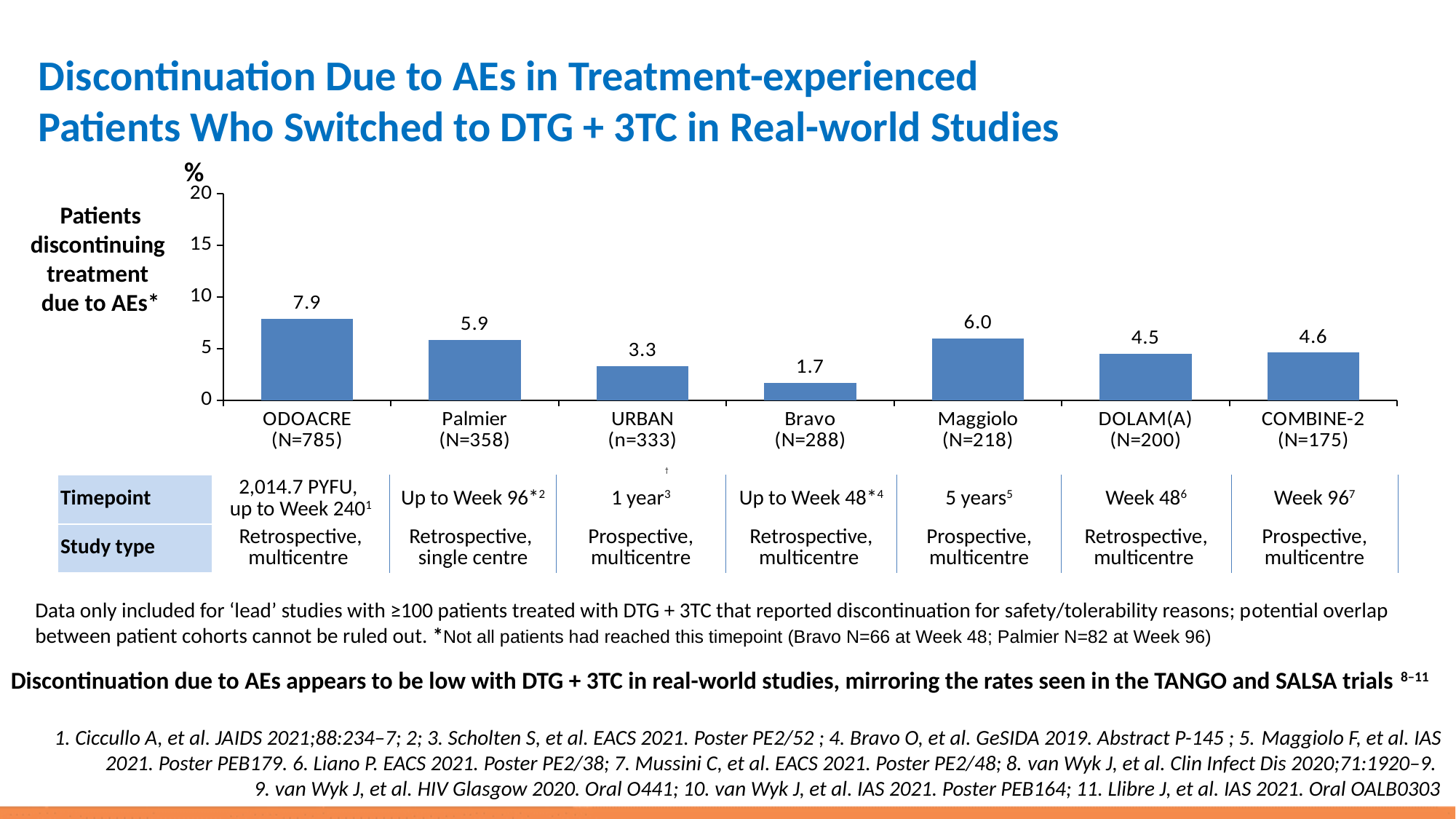
What is the value shown for the Maggiolo study? 6.0 Is the value for Maggiolo greater or less than 5? greater What is the value shown for the Bravo study? 1.7 How many studies are shown in the chart? 7 What is the difference between the values for ODOACRE and Palmier? 2.0 What percentage of patients discontinued treatment due to AEs in the ODOACRE study? 7.9 What kind of chart is shown on the slide? Bar chart Which study has the highest percentage of patients discontinuing treatment due to AEs? ODOACRE Which study has the lowest percentage of patients discontinuing treatment due to AEs? Bravo What is the unit shown on the y axis of the chart? % Which has a higher value, URBAN or DOLAM(A)? DOLAM(A) What is the value shown for COMBINE-2? 4.6